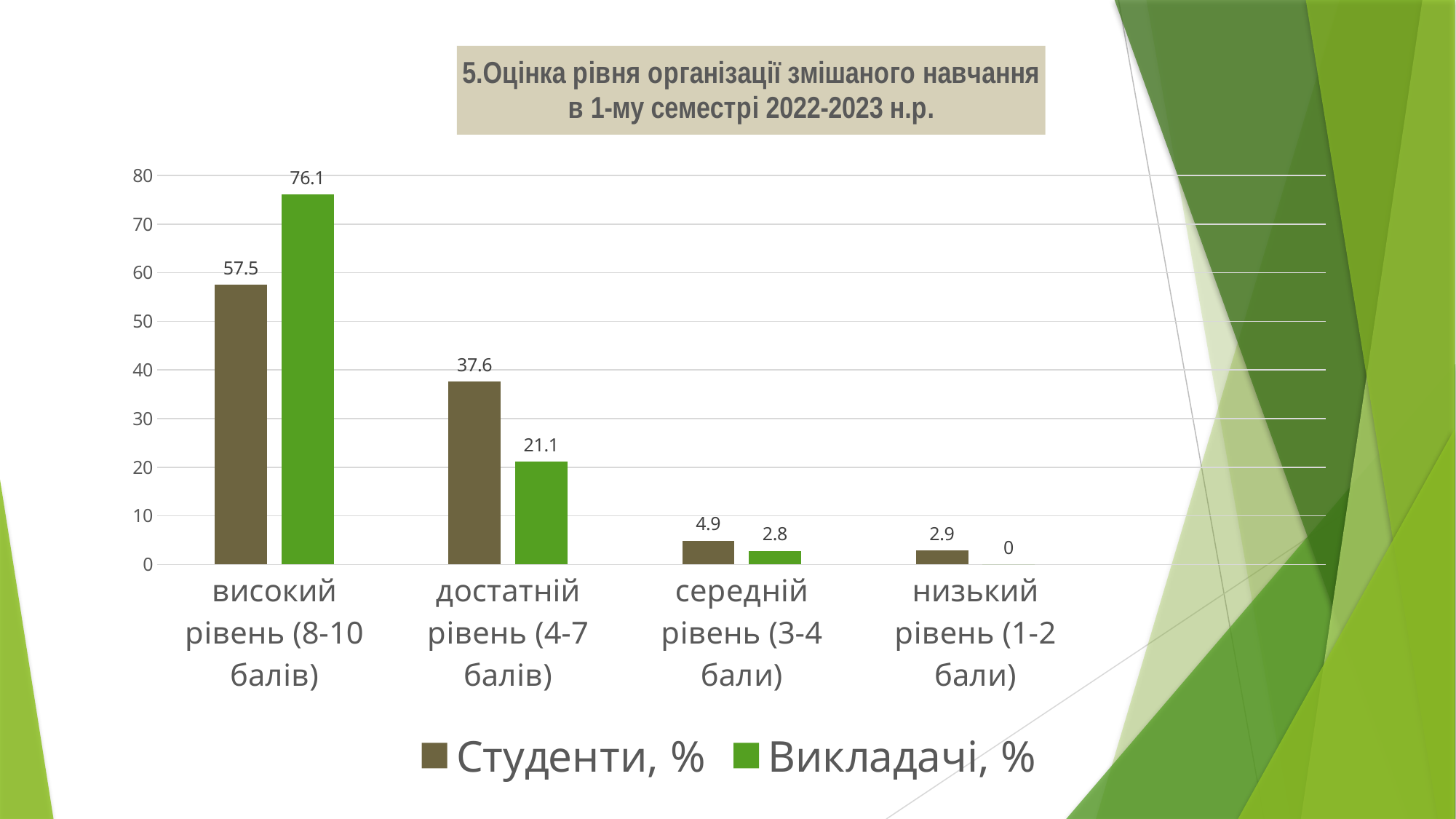
What is the value for Викладачі, % at високий рівень (8-10 балів)? 76.1 What is the difference between Викладачі, % and Студенти, % at високий рівень (8-10 балів)? 18.6 What kind of chart is shown on the slide? bar chart What is the value for Студенти, % at високий рівень (8-10 балів)? 57.5 Which category has the highest value for Викладачі, %? високий рівень (8-10 балів) What is the value for Викладачі, % at низький рівень (1-2 бали)? 0 How many series does the legend list? 2 What is the value for Студенти, % at достатній рівень (4-7 балів)? 37.6 Which is larger at достатній рівень (4-7 балів): Студенти, % or Викладачі, %? Студенти, % How many categories are shown on the x axis? 4 Do the values for Студенти, % rise or fall from високий рівень to низький рівень along the x axis? fall Which category has the lowest value for Студенти, %? низький рівень (1-2 бали)